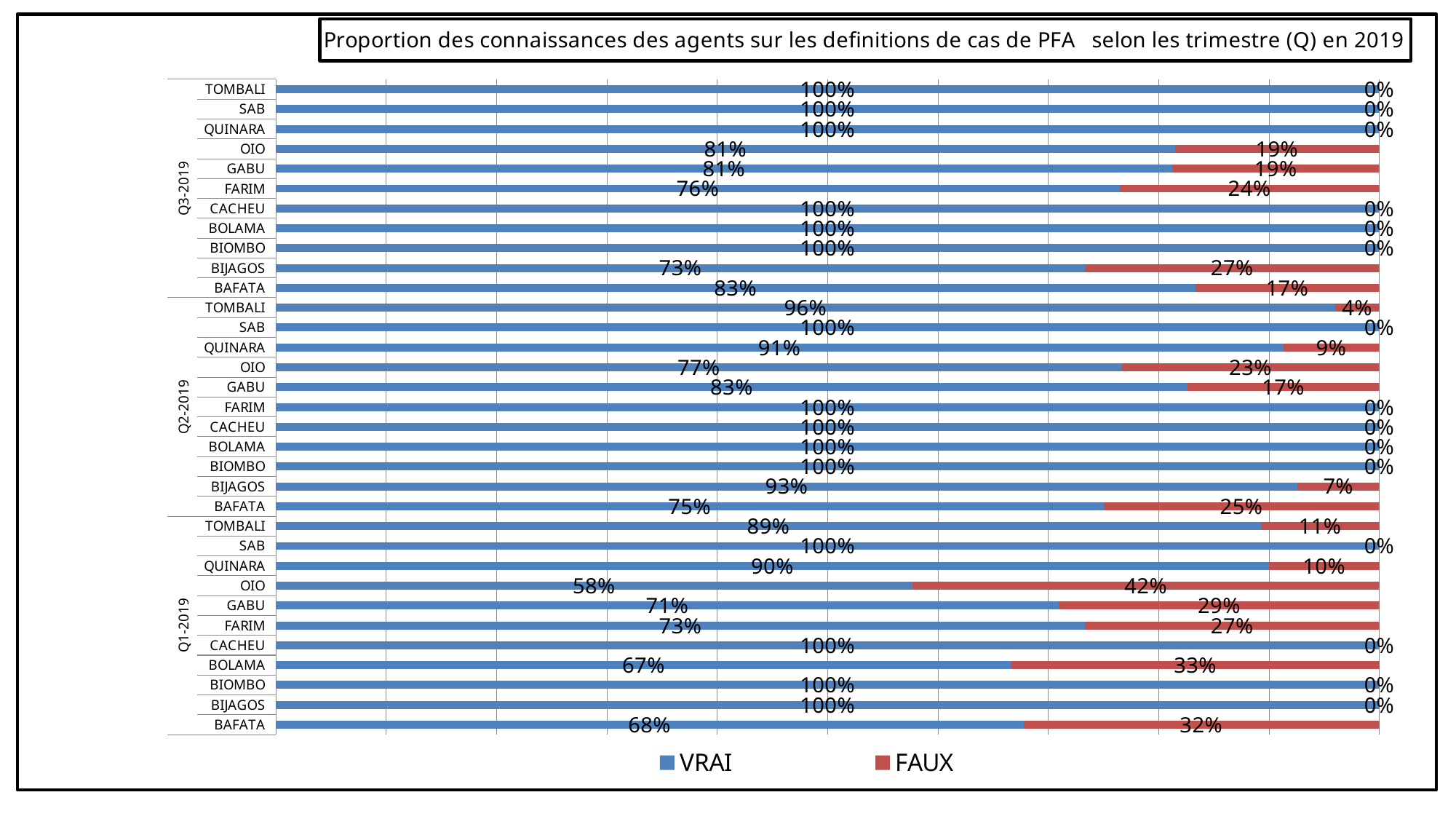
What is the FAUX value for TOMBALI in Q2-2019? 4% What kind of chart is shown on the slide? Stacked bar chart Within Q3-2019, which region has the highest FAUX value? BIJAGOS What is the VRAI value for OIO in Q1-2019? 58% What is the total of the stacked bar for BAFATA in Q1-2019 (VRAI plus FAUX)? 100% What is the FAUX value for BOLAMA in Q1-2019? 33% Within Q1-2019, which region has the lowest VRAI value? OIO How many percentage points higher is the VRAI value for BAFATA in Q3-2019 than in Q1-2019? 15 percentage points How many series does the legend list? 2 In Q1-2019, which has the larger VRAI value, GABU or FARIM? FARIM What is the VRAI value for BIJAGOS in Q3-2019? 73% How many regions are listed within each quarter group? 11